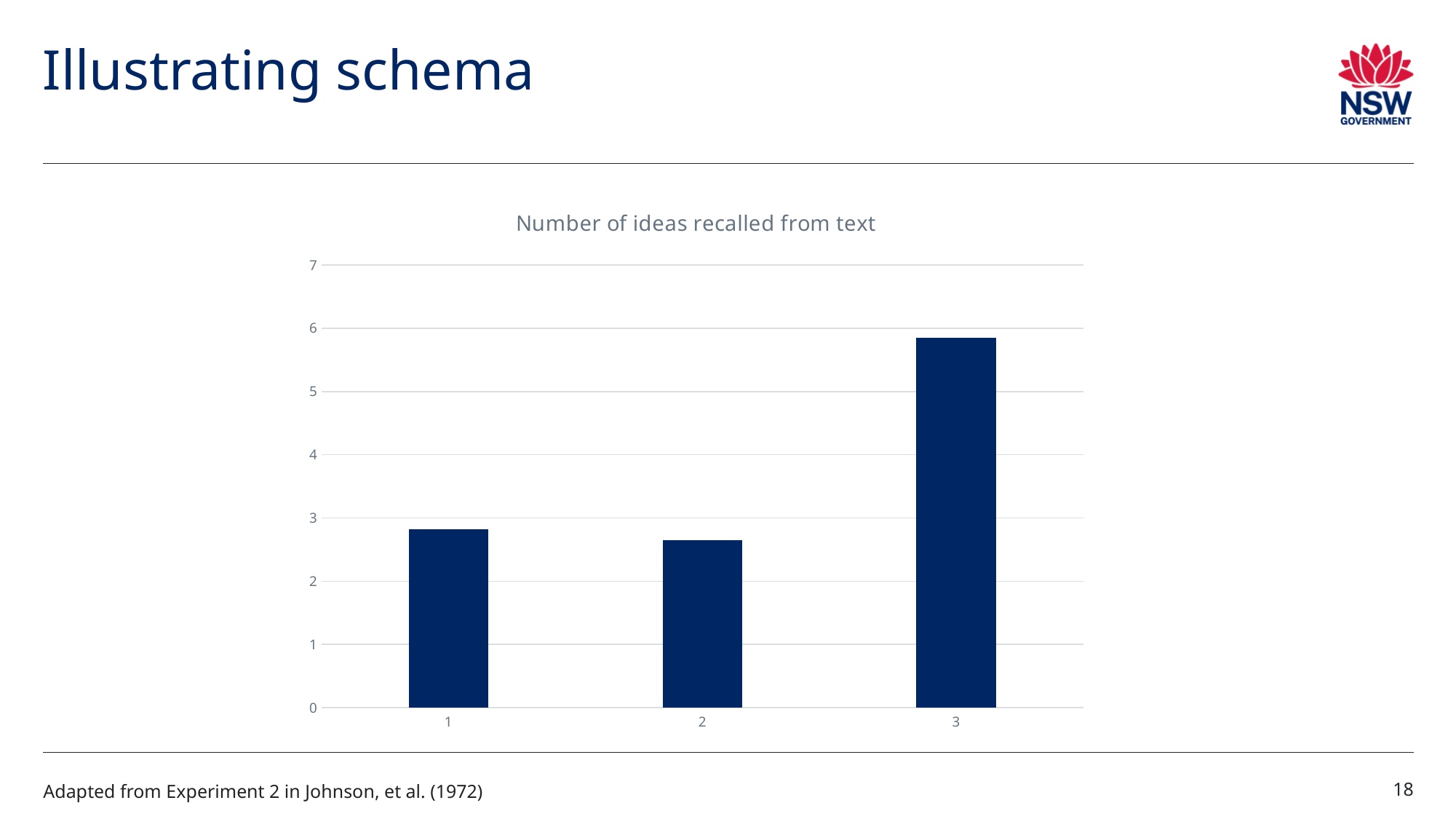
What is the highest value shown on the vertical axis? 7 Is the value for category 1 greater or less than 3? less Is the value for category 2 greater or less than 3? less Is the value for category 1 greater or less than 2? greater What is the title of the chart? Number of ideas recalled from text How many bars does the chart show? 3 Which is larger, the value for category 2 or the value for category 3? 3 What kind of chart is shown on the slide? bar chart Which category has the highest number of ideas recalled? 3 Which is larger, the value for category 3 or the value for category 1? 3